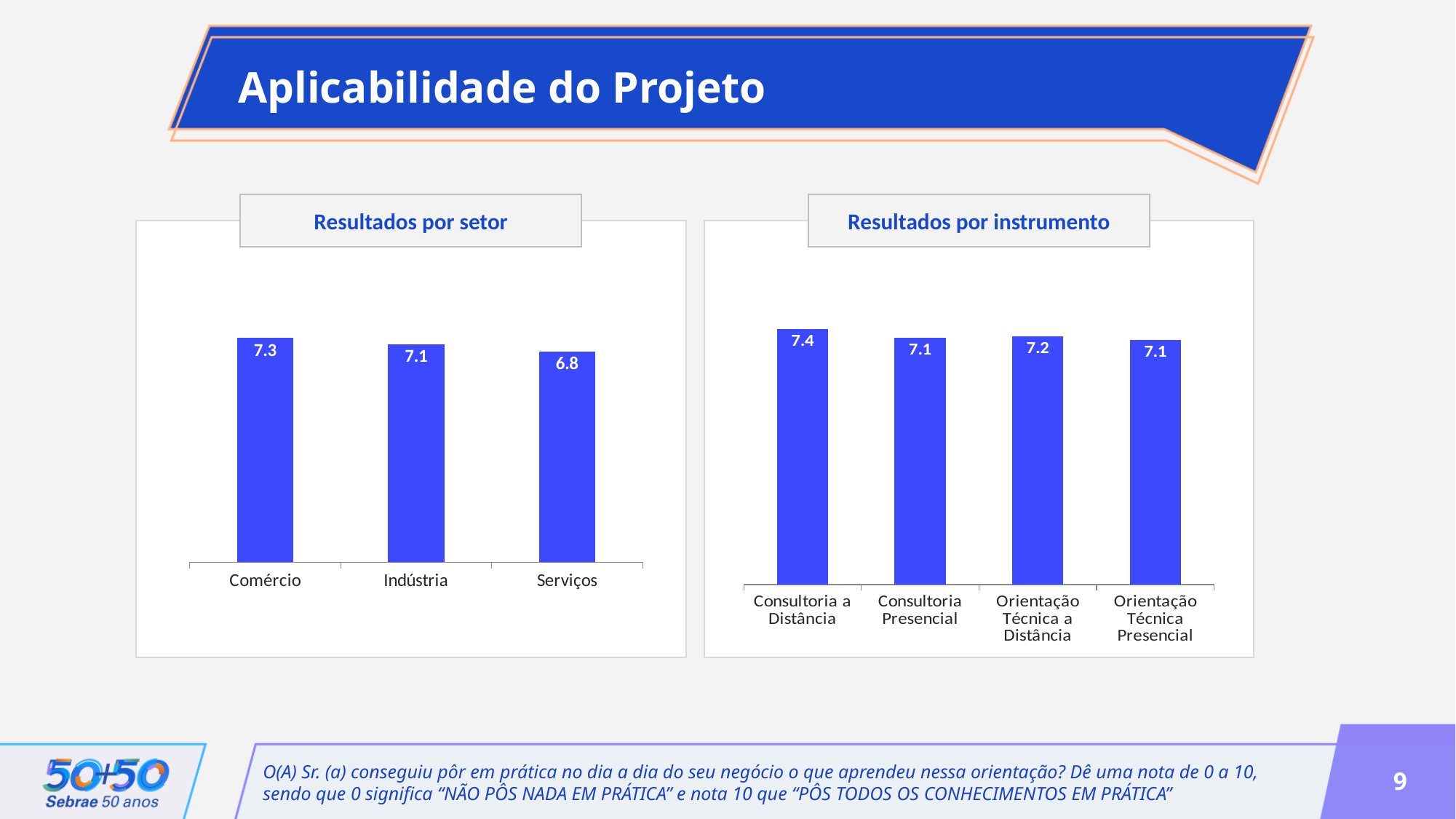
What type of chart is the 'Resultados por setor' chart? Bar chart In the 'Resultados por instrumento' chart, what is the difference between Consultoria a Distância and Consultoria Presencial? 0.3 In the 'Resultados por setor' chart, which sector has the highest value? Comércio In the 'Resultados por instrumento' chart, which instrument has the highest value? Consultoria a Distância In the 'Resultados por instrumento' chart, what is the value for Consultoria a Distância? 7.4 In the 'Resultados por setor' chart, how many sectors are shown? 3 In the 'Resultados por setor' chart, what is the difference between Comércio and Serviços? 0.5 In the 'Resultados por setor' chart, which sector has the lowest value? Serviços In the 'Resultados por setor' chart, what is the value for Comércio? 7.3 In the 'Resultados por instrumento' chart, what is the value for Orientação Técnica a Distância? 7.2 In the 'Resultados por instrumento' chart, how many instruments are shown? 4 In the 'Resultados por setor' chart, what is the value for Serviços? 6.8